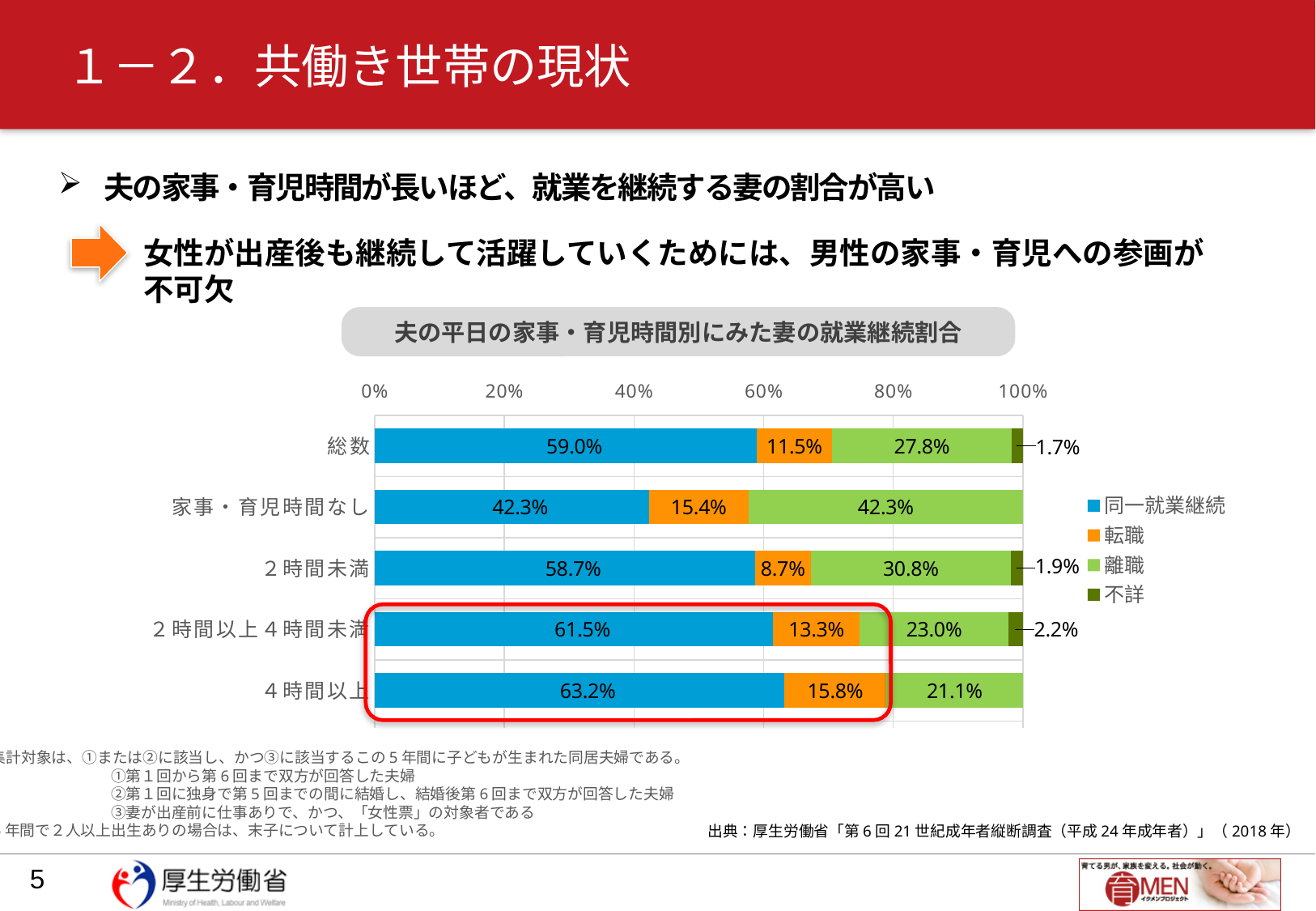
What is the title of the chart? 夫の平日の家事・育児時間別にみた妻の就業継続割合 What is the 不詳 value for 総数? 1.7% Which is larger, the 離職 value for 2時間未満 or for 4時間以上? 2時間未満 What is the difference between the 同一就業継続 values for 4時間以上 and 家事・育児時間なし? 20.9% Which category has the lowest 転職 value? 2時間未満 What is the 同一就業継続 value for 4時間以上? 63.2% How many categories are shown on the vertical axis of the chart? 5 How many series does the legend list? 4 Which category has the highest 同一就業継続 value? 4時間以上 What is the 離職 value for 2時間以上4時間未満? 23.0% What is the 転職 value for 家事・育児時間なし? 15.4% What type of chart is shown on the slide? stacked bar chart